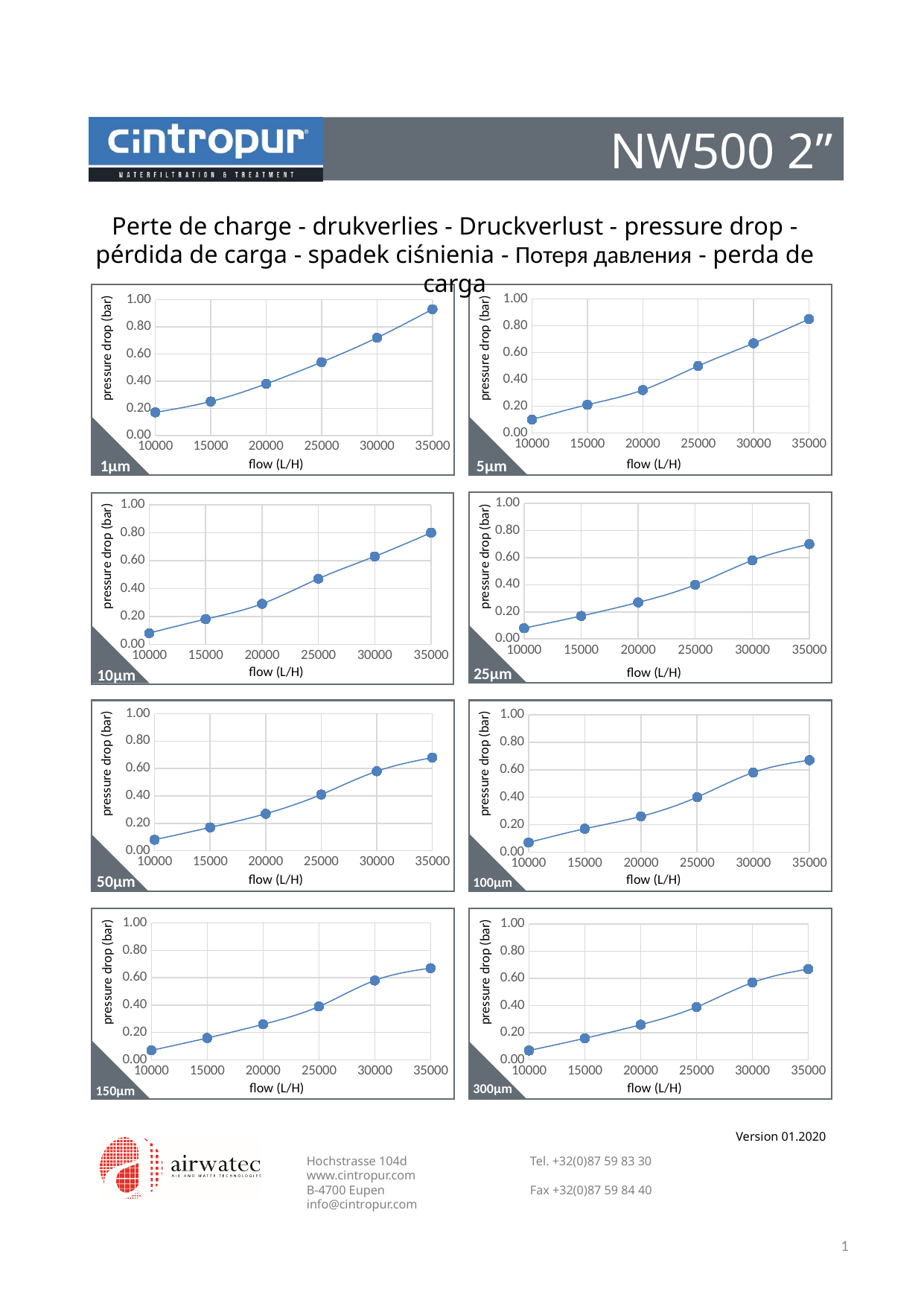
On the 300µm chart, is the pressure drop at 10000 L/H greater or less than 0.20 bar? less On the 50µm chart, at which flow value is the pressure drop highest? 35000 At 35000 L/H, which chart shows the larger pressure drop, the 1µm chart or the 5µm chart? 1µm chart What is the x-axis label on the 1µm chart? flow (L/H) On the 100µm chart, at which flow value is the pressure drop lowest? 10000 On the 25µm chart, is the pressure drop at 35000 L/H greater or less than 0.60 bar? greater On the 150µm chart, does the pressure drop rise or fall as flow increases? rises On the 1µm chart, is the pressure drop at 35000 L/H greater or less than 0.80 bar? greater What kind of chart is the 1µm chart? line chart How many data points are plotted on the 5µm chart? 6